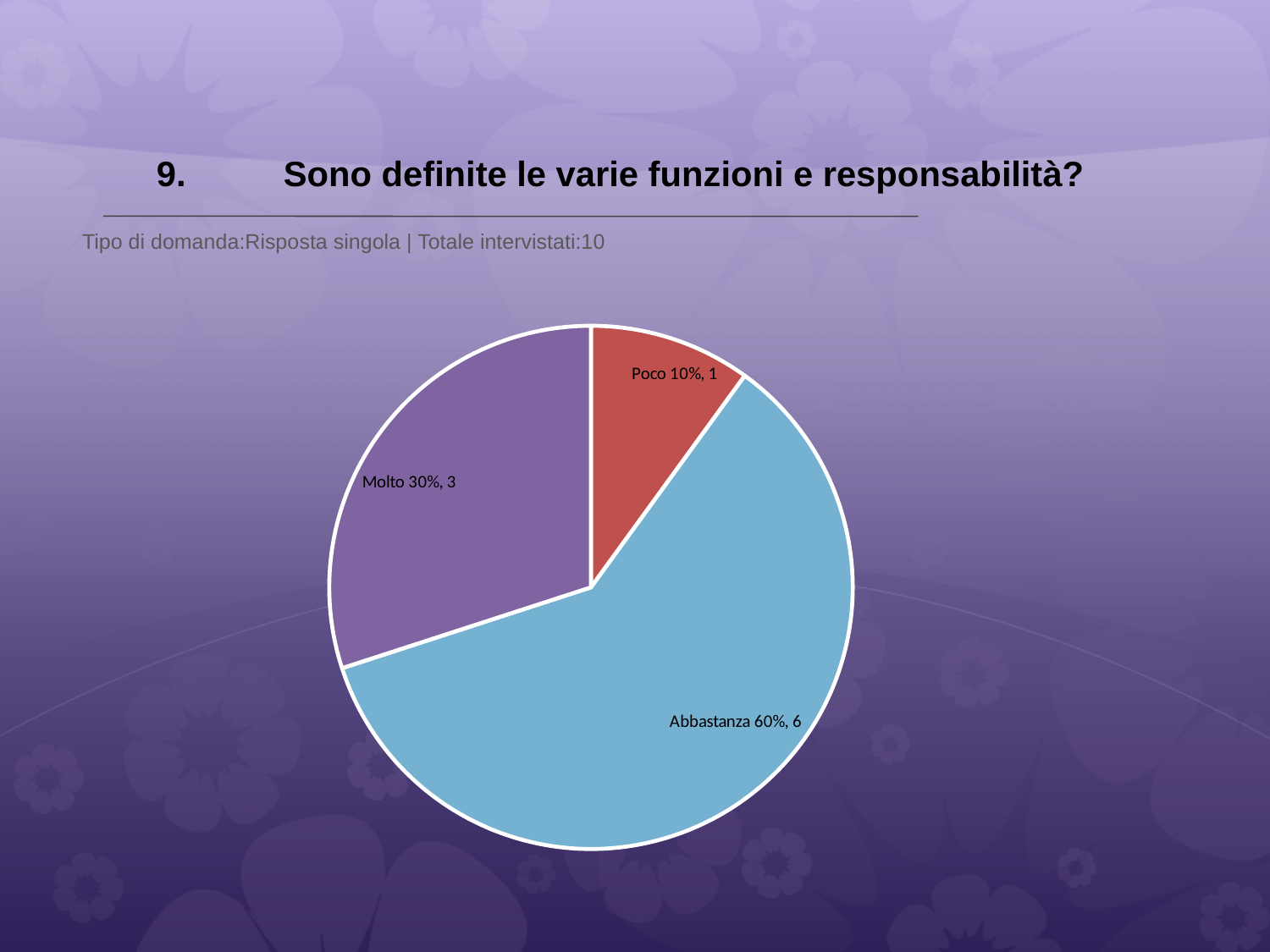
How many respondents answered "Abbastanza"? 6 What percentage share does the "Poco" slice have? 10% How many respondents answered "Poco"? 1 How many respondents answered "Molto"? 3 Which slice is larger, "Molto" or "Poco"? Molto Which category has the smallest slice of the pie? Poco What is the difference in respondents between "Abbastanza" and "Molto"? 3 What percentage share does the "Molto" slice have? 30% What percentage share does the "Abbastanza" slice have? 60% How many slices does the pie chart have? 3 What kind of chart is shown on the slide? pie chart Which category has the largest slice of the pie? Abbastanza